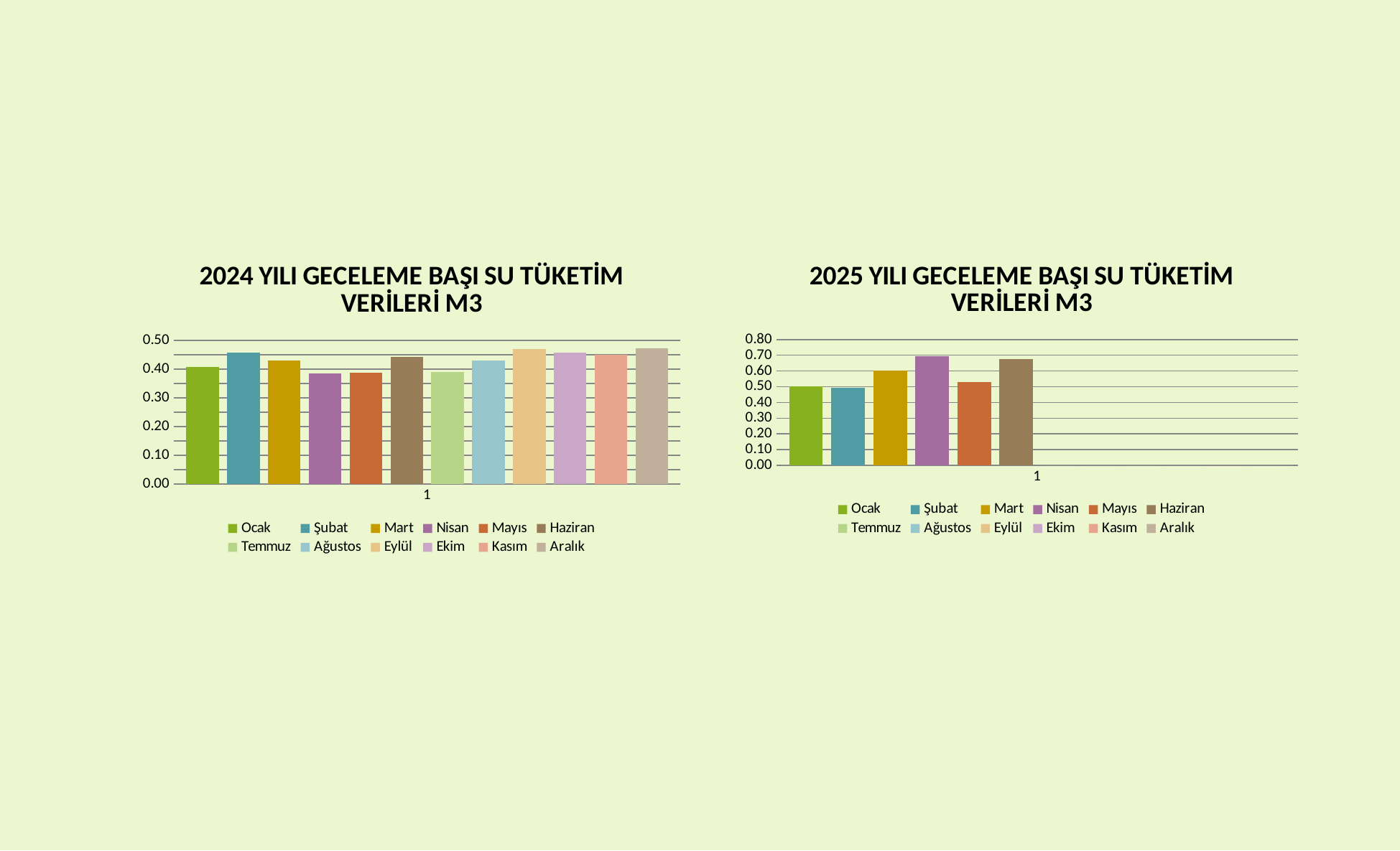
What kind of chart is the 2024 YILI GECELEME BAŞI SU TÜKETİM VERİLERİ M3 chart? bar chart In the 2025 YILI GECELEME BAŞI SU TÜKETİM VERİLERİ M3 chart, which month has the highest value? Nisan In the 2025 YILI GECELEME BAŞI SU TÜKETİM VERİLERİ M3 chart, is the value for Mart greater or less than 0.50? greater In the 2025 YILI GECELEME BAŞI SU TÜKETİM VERİLERİ M3 chart, is the value for Haziran greater or less than 0.60? greater In the 2024 YILI GECELEME BAŞI SU TÜKETİM VERİLERİ M3 chart, is the value for Eylül greater or less than 0.40? greater In the 2024 YILI GECELEME BAŞI SU TÜKETİM VERİLERİ M3 chart, which is larger, Şubat or Nisan? Şubat How many series does the legend of the 2024 YILI GECELEME BAŞI SU TÜKETİM VERİLERİ M3 chart list? 12 How many bars are plotted in the 2025 YILI GECELEME BAŞI SU TÜKETİM VERİLERİ M3 chart? 6 What is the highest value shown on the y axis of the 2025 YILI GECELEME BAŞI SU TÜKETİM VERİLERİ M3 chart? 0.80 In the 2025 YILI GECELEME BAŞI SU TÜKETİM VERİLERİ M3 chart, which is larger, Nisan or Mayıs? Nisan